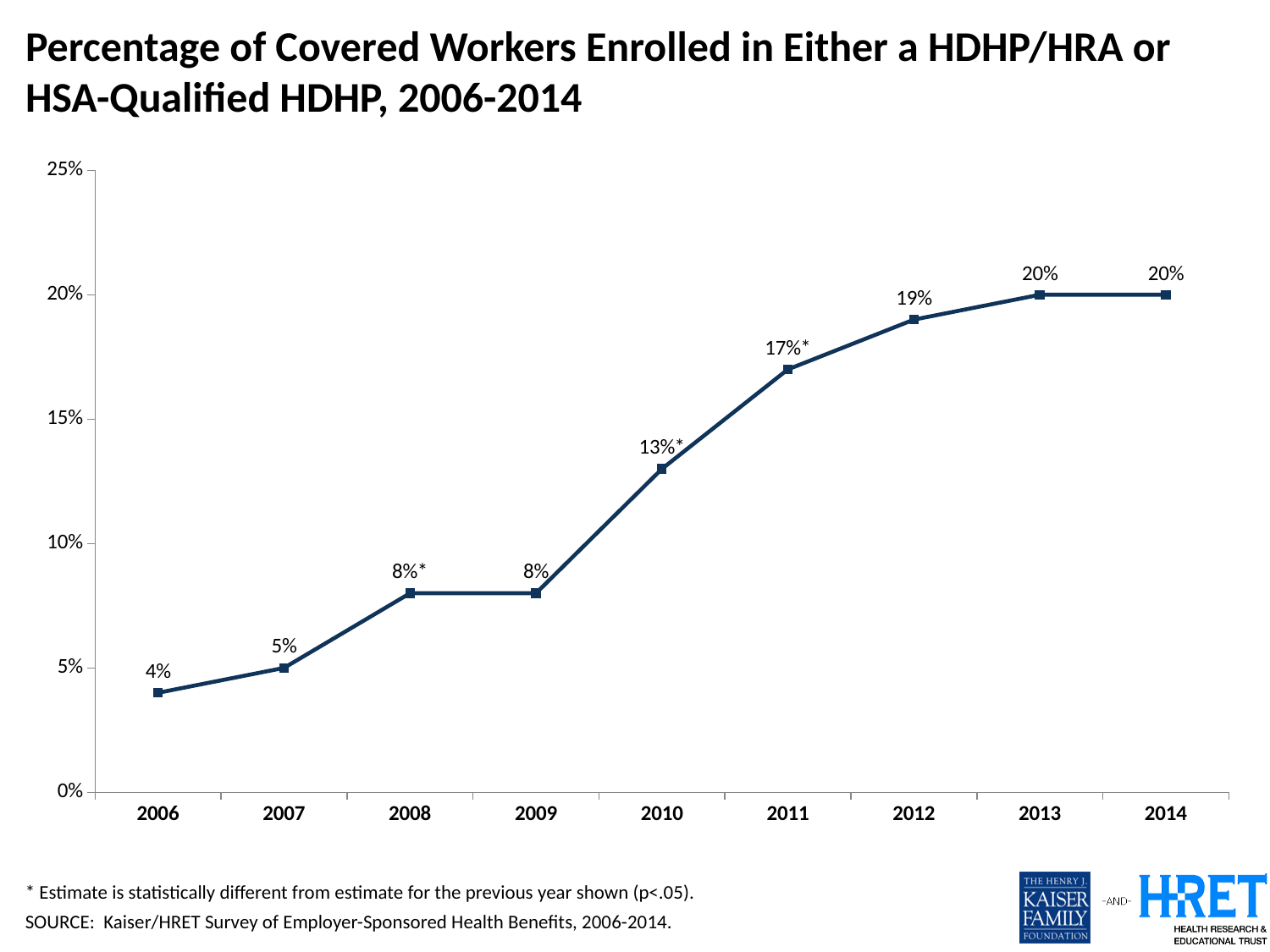
Which year has a larger value, 2007 or 2012? 2012 What is the value shown for 2012? 19% Is the value for 2011 greater or less than 15%? greater What is the value shown for 2006? 4% Do the values generally rise or fall from 2006 to 2014? Rise What kind of chart is shown on the slide? Line chart What percentage of covered workers were enrolled in either a HDHP/HRA or HSA-qualified HDHP in 2010? 13% Which year has the lowest percentage of covered workers enrolled? 2006 What is the difference between the values for 2011 and 2009? 9% According to the footnote, what does the asterisk next to a value indicate? Estimate is statistically different from estimate for the previous year shown (p<.05) How many years are plotted on the x axis? 9 What is the highest value plotted on the chart? 20%